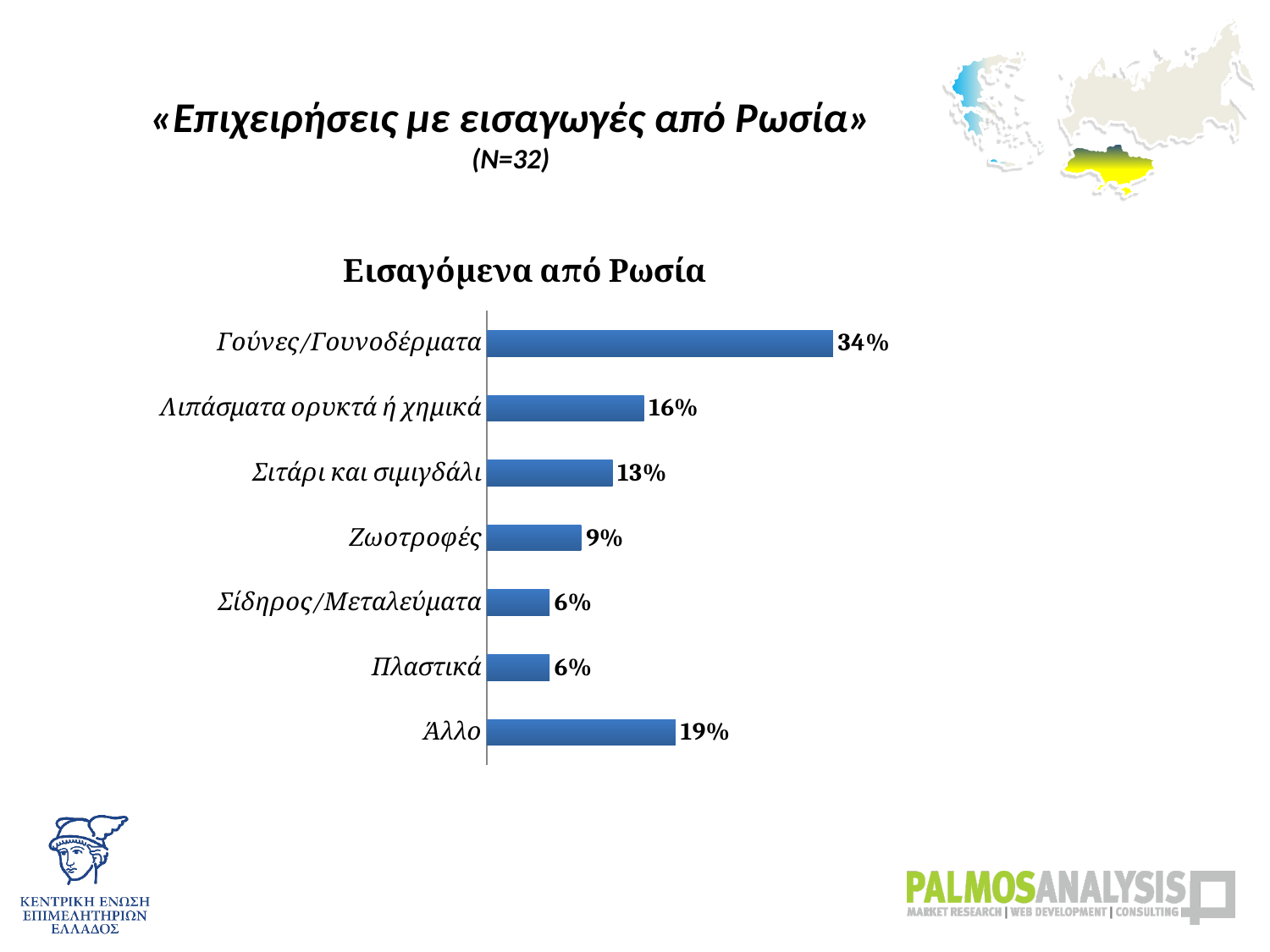
Which is larger, Σιτάρι και σιμιγδάλι or Ζωοτροφές? Σιτάρι και σιμιγδάλι What kind of chart is shown? Bar chart What is the title of the chart? Εισαγόμενα από Ρωσία Which category has the highest value? Γούνες/Γουνοδέρματα What is the difference between Άλλο and Ζωοτροφές? 10% What is the difference between Γούνες/Γουνοδέρματα and Λιπάσματα ορυκτά ή χημικά? 18% What is the value for Λιπάσματα ορυκτά ή χημικά? 16% What is the value for Σιτάρι και σιμιγδάλι? 13% What is the value for Γούνες/Γουνοδέρματα? 34% What is the value for Άλλο? 19% How many categories are shown in the chart? 7 Which is larger, Άλλο or Λιπάσματα ορυκτά ή χημικά? Άλλο